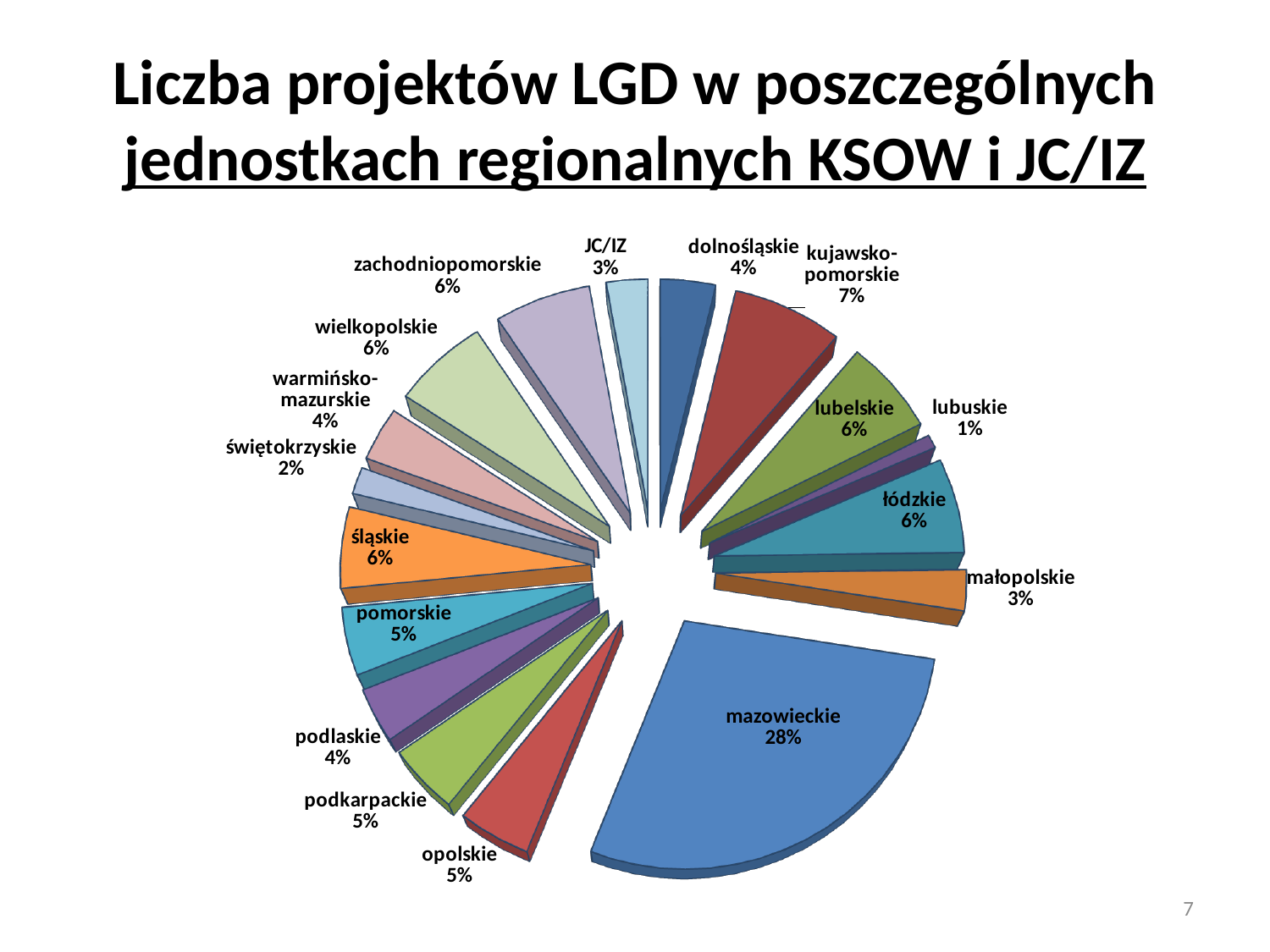
Which has a larger share, pomorskie or śląskie? śląskie Which slice has the largest share of the pie? mazowieckie What is the difference in percentage points between mazowieckie and kujawsko-pomorskie? 21 What kind of chart is shown on the slide? pie chart How many slices does the pie chart have? 17 What is the title of the slide? Liczba projektów LGD w poszczególnych jednostkach regionalnych KSOW i JC/IZ What is the value shown for JC/IZ? 3% What is the value shown for kujawsko-pomorskie? 7% What share of the pie does mazowieckie have? 28% What is the value shown for lubuskie? 1% Which slice has the smallest share of the pie? lubuskie What is the value shown for świętokrzyskie? 2%